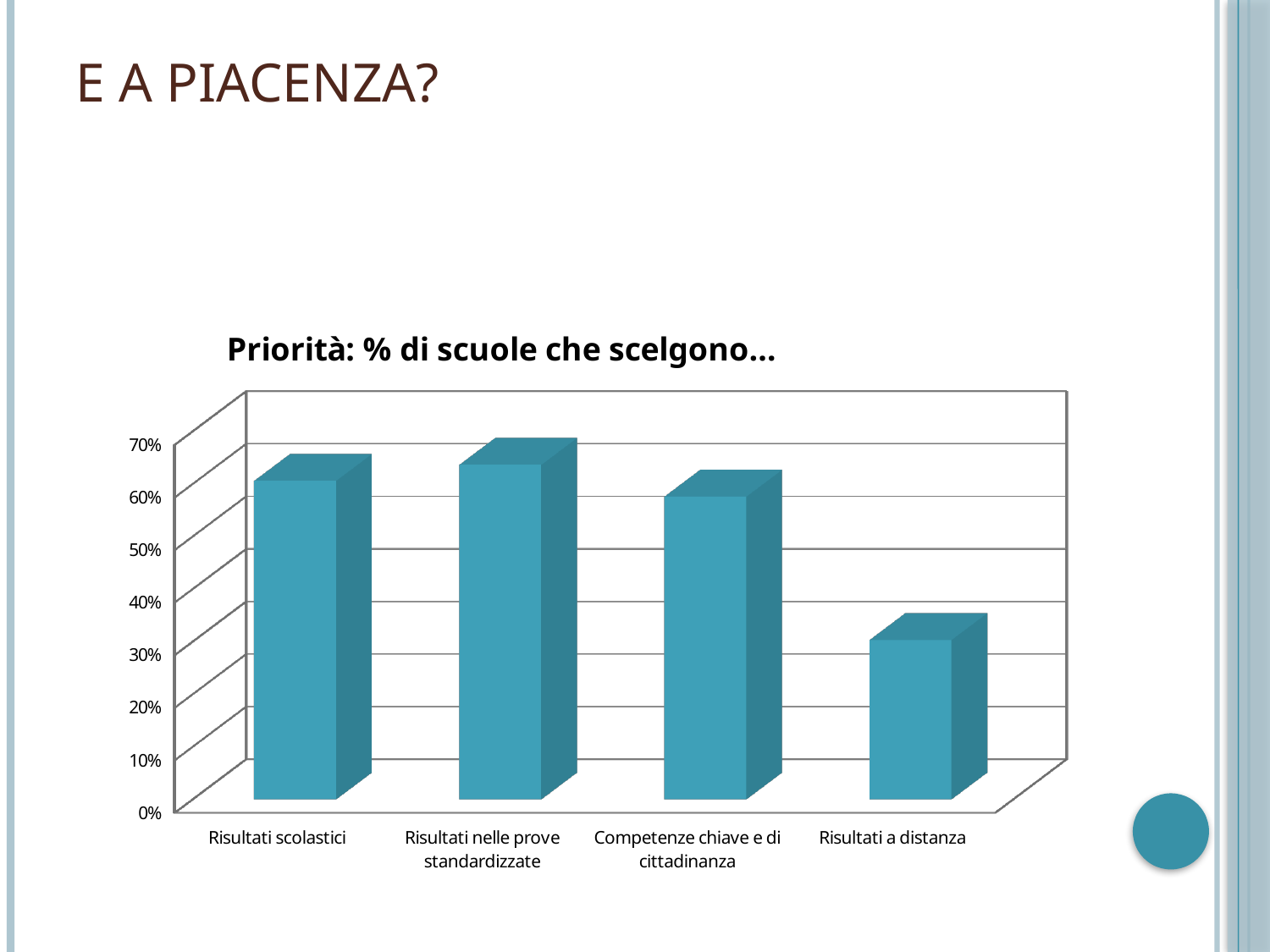
Is the value for Risultati a distanza greater or less than 20%? greater Is the value for Risultati scolastici greater or less than 50%? greater How many categories are shown on the x axis of the chart? 4 Which is larger, the value for Risultati scolastici or the value for Risultati a distanza? Risultati scolastici Which category has the lowest value in the chart? Risultati a distanza Which category has the highest value in the chart? Risultati nelle prove standardizzate Is the value for Competenze chiave e di cittadinanza greater or less than 40%? greater Which is larger, the value for Competenze chiave e di cittadinanza or the value for Risultati a distanza? Competenze chiave e di cittadinanza What kind of chart is shown on the slide? Bar chart What is the title of the chart? Priorità: % di scuole che scelgono…